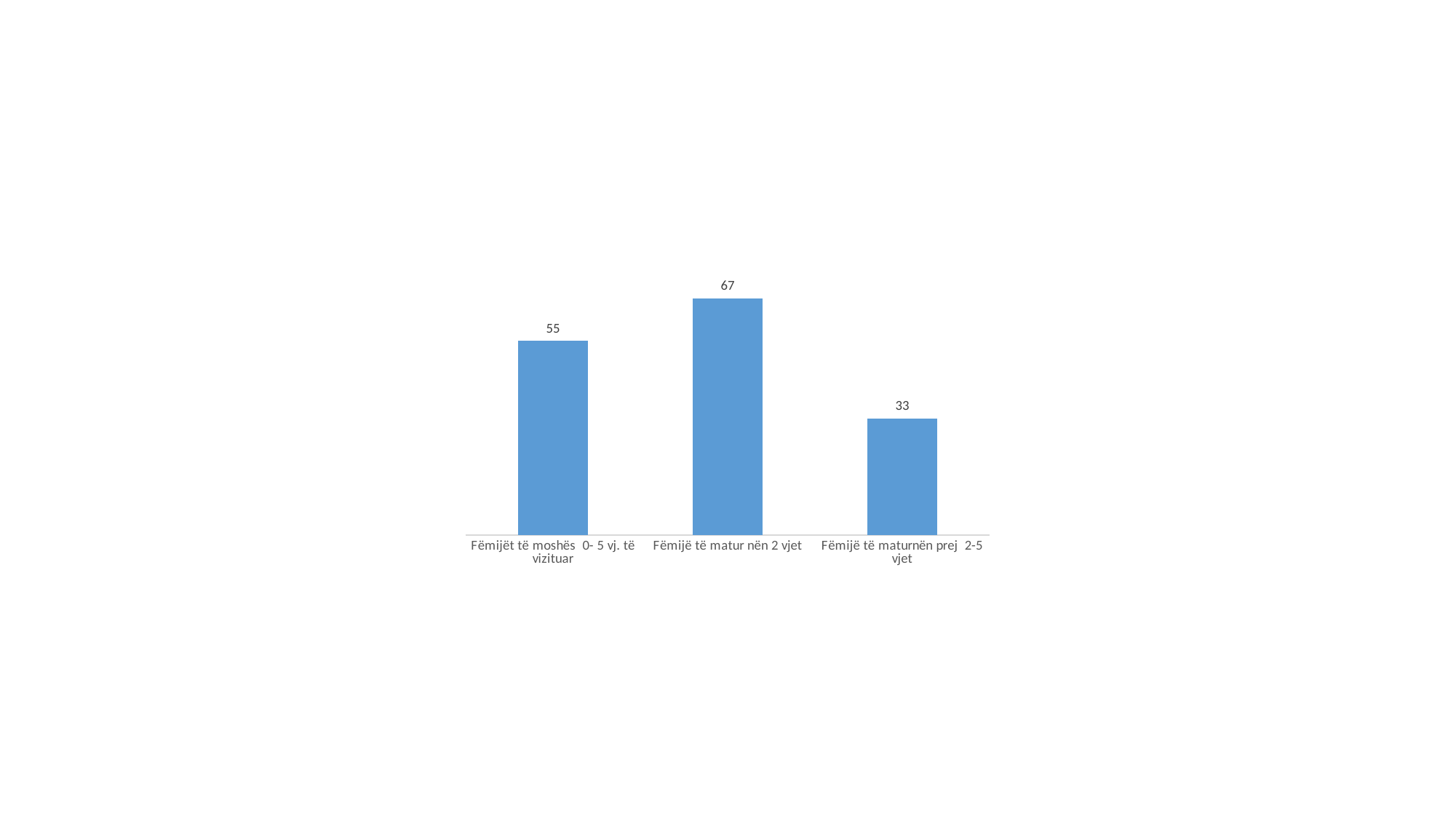
What is the difference between the values for "Fëmijë të matur nën 2 vjet" and "Fëmijë të maturnën prej 2-5 vjet"? 34 What is the value for "Fëmijë të matur nën 2 vjet"? 67 What kind of chart is shown on the slide? Bar chart What is the value for "Fëmijët të moshës 0- 5 vj. të vizituar"? 55 What colour are the bars in the chart? Blue What is the value for "Fëmijë të maturnën prej 2-5 vjet"? 33 Which category has the highest value? Fëmijë të matur nën 2 vjet Does the chart show a legend? No Which is larger: the value for "Fëmijët të moshës 0- 5 vj. të vizituar" or the value for "Fëmijë të maturnën prej 2-5 vjet"? Fëmijët të moshës 0- 5 vj. të vizituar What is the difference between the values for "Fëmijë të matur nën 2 vjet" and "Fëmijët të moshës 0- 5 vj. të vizituar"? 12 How many categories are shown in the chart? 3 Which category has the lowest value? Fëmijë të maturnën prej 2-5 vjet